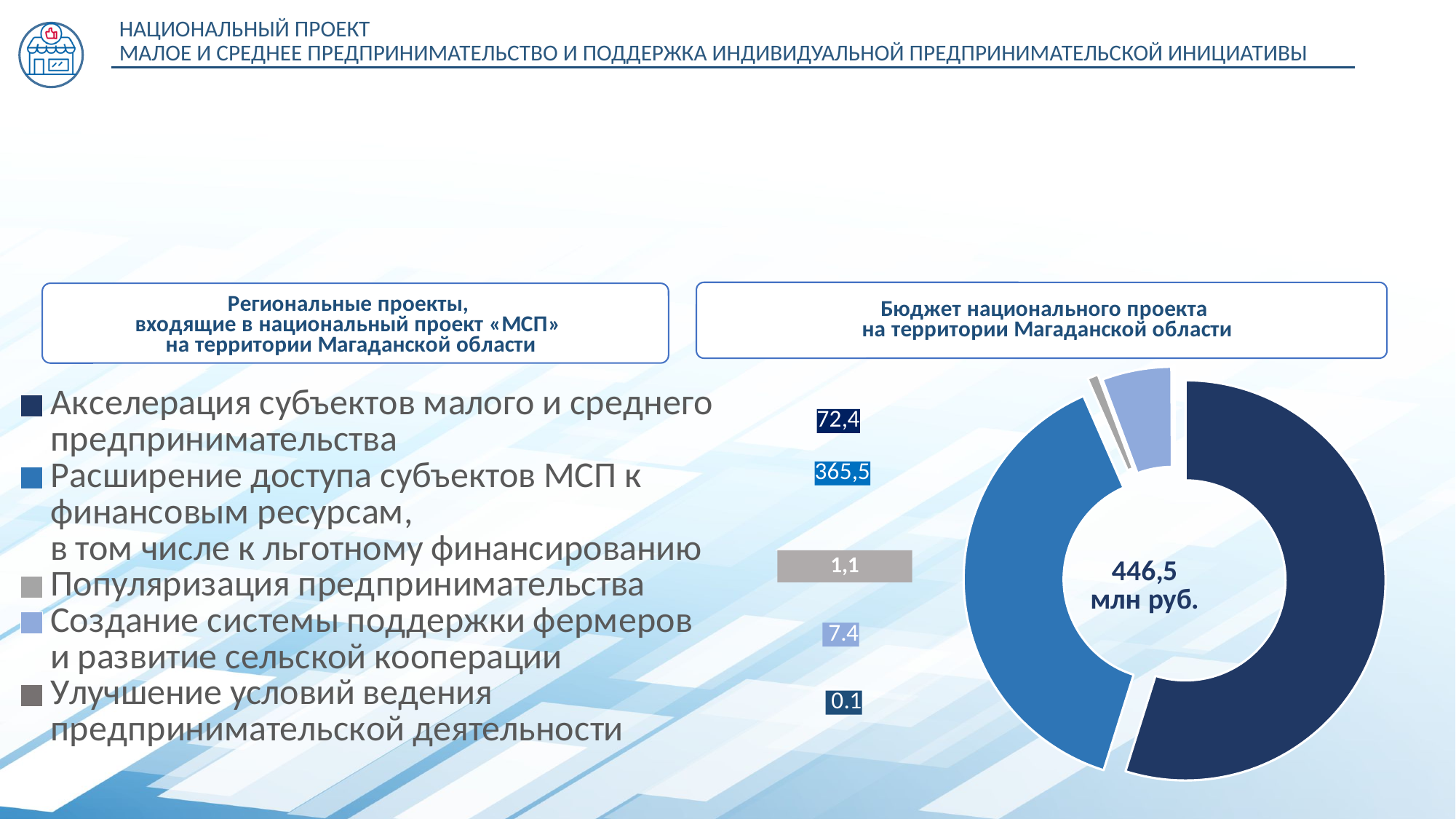
What is the value for «Расширение доступа субъектов МСП к финансовым ресурсам, в том числе к льготному финансированию» in the budget chart? 365,5 What is the difference between the values for «Расширение доступа субъектов МСП к финансовым ресурсам» and «Акселерация субъектов малого и среднего предпринимательства»? 293,1 Which is larger: the value for «Акселерация субъектов малого и среднего предпринимательства» or for «Создание системы поддержки фермеров и развитие сельской кооперации»? Акселерация субъектов малого и среднего предпринимательства Which category has the smallest value in the budget chart? Улучшение условий ведения предпринимательской деятельности What is the value for «Создание системы поддержки фермеров и развитие сельской кооперации» in the budget chart? 7.4 What is the value for «Популяризация предпринимательства» in the budget chart? 1,1 What is the value for «Улучшение условий ведения предпринимательской деятельности» in the budget chart? 0.1 What is the value for «Акселерация субъектов малого и среднего предпринимательства» in the budget chart? 72,4 What total is printed in the centre of the budget chart? 446,5 млн руб. What kind of chart is used to show the budget of the national project? Doughnut chart How many categories does the budget chart show? 5